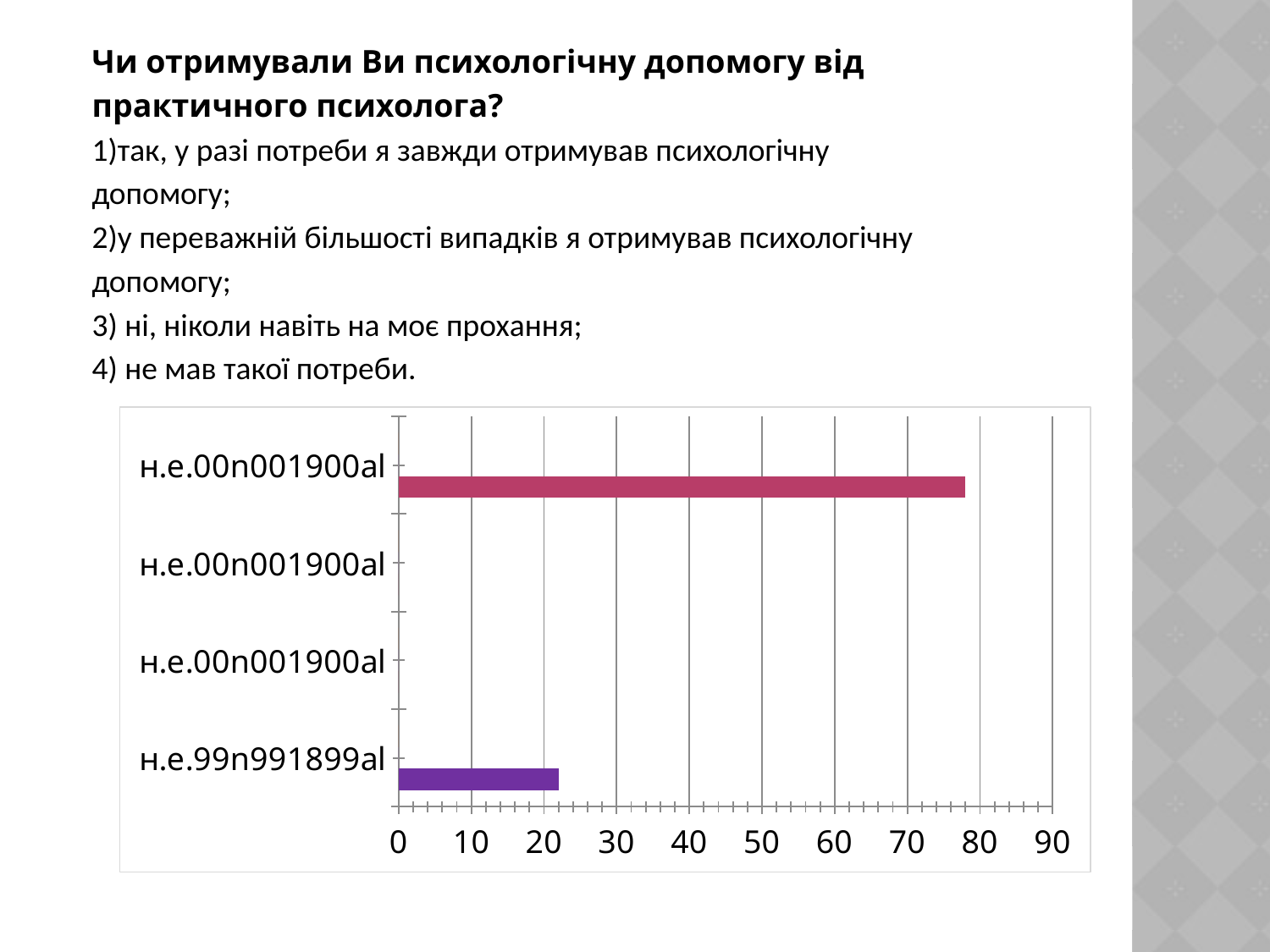
Which bar in the chart is the longest, the top one or the bottom one? the top one Is the value of the top bar in the chart greater or less than 80? less Which is larger, the value of the top bar or the value of the bottom bar? the top bar Is the value of the top bar in the chart greater or less than 70? greater How many categories in the chart have a visible bar? 2 What is the highest value shown on the horizontal axis of the chart? 90 What colour is the bottom bar in the chart? purple Is the value of the bottom bar in the chart greater or less than 30? less How many categories are listed on the vertical axis of the chart? 4 What kind of chart is shown on the slide? bar chart